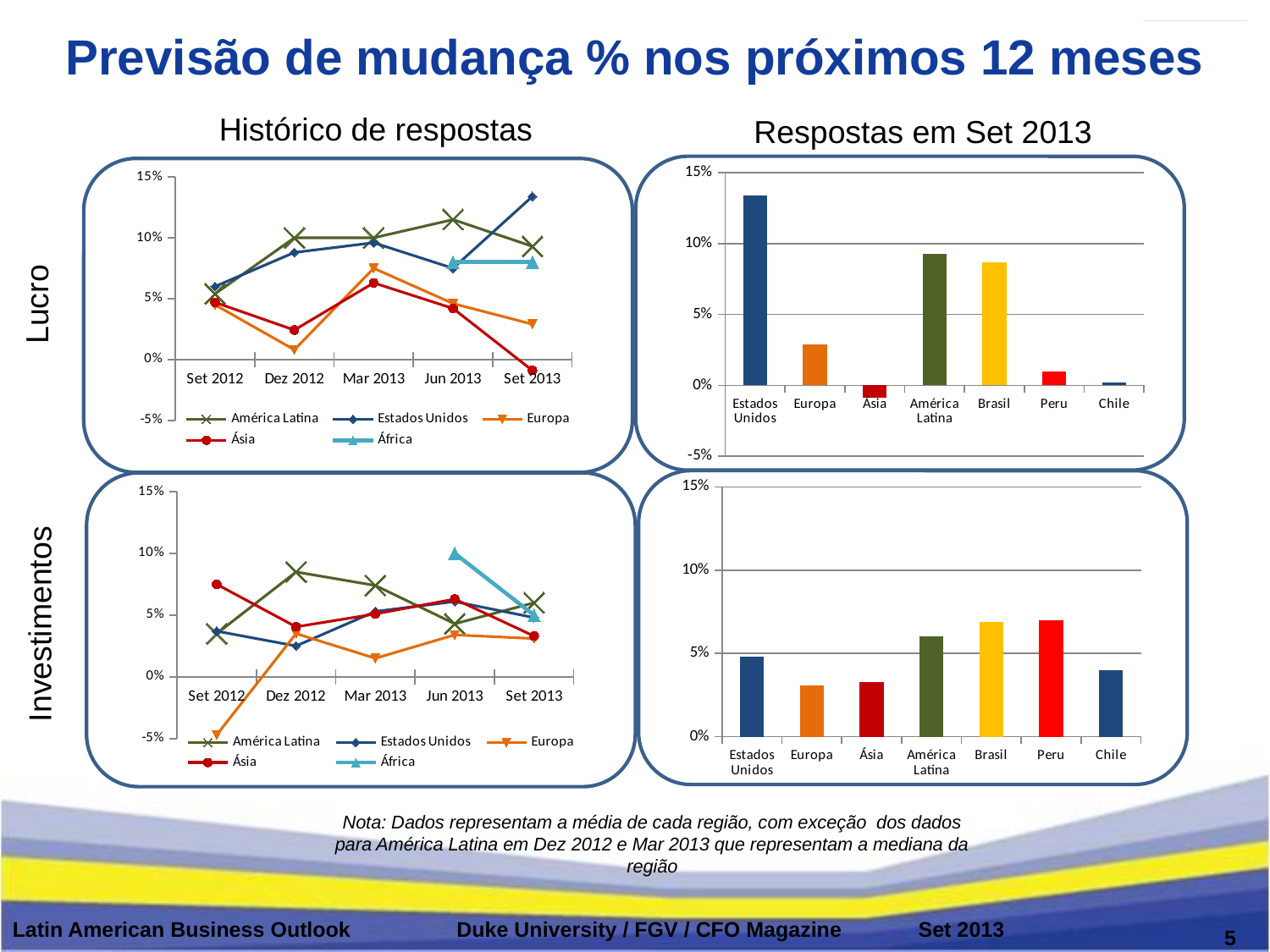
In the top-right bar chart (Lucro, Respostas em Set 2013), is the value for Estados Unidos greater or less than 10%? greater In the bottom-right bar chart (Investimentos, Respostas em Set 2013), is the value for Brasil greater or less than 5%? greater How many series does the legend of the top-left line chart (Lucro, Histórico de respostas) list? 5 In the bottom-right bar chart (Investimentos, Respostas em Set 2013), is the value for Europa greater or less than 5%? less In the bottom-right bar chart (Investimentos, Respostas em Set 2013), which is larger, the value for América Latina or the value for Chile? América Latina In the bottom-left line chart (Investimentos, Histórico de respostas), does the África series rise or fall from Jun 2013 to Set 2013? Fall In the top-right bar chart (Lucro, Respostas em Set 2013), how many regions are shown on the x axis? 7 In the top-right bar chart (Lucro, Respostas em Set 2013), which region has the highest value? Estados Unidos In the top-left line chart (Lucro, Histórico de respostas), does the Ásia series rise or fall from Jun 2013 to Set 2013? Fall What kind of chart is the top-left chart (Lucro, Histórico de respostas)? Line chart In the top-right bar chart (Lucro, Respostas em Set 2013), which region has the lowest value? Ásia